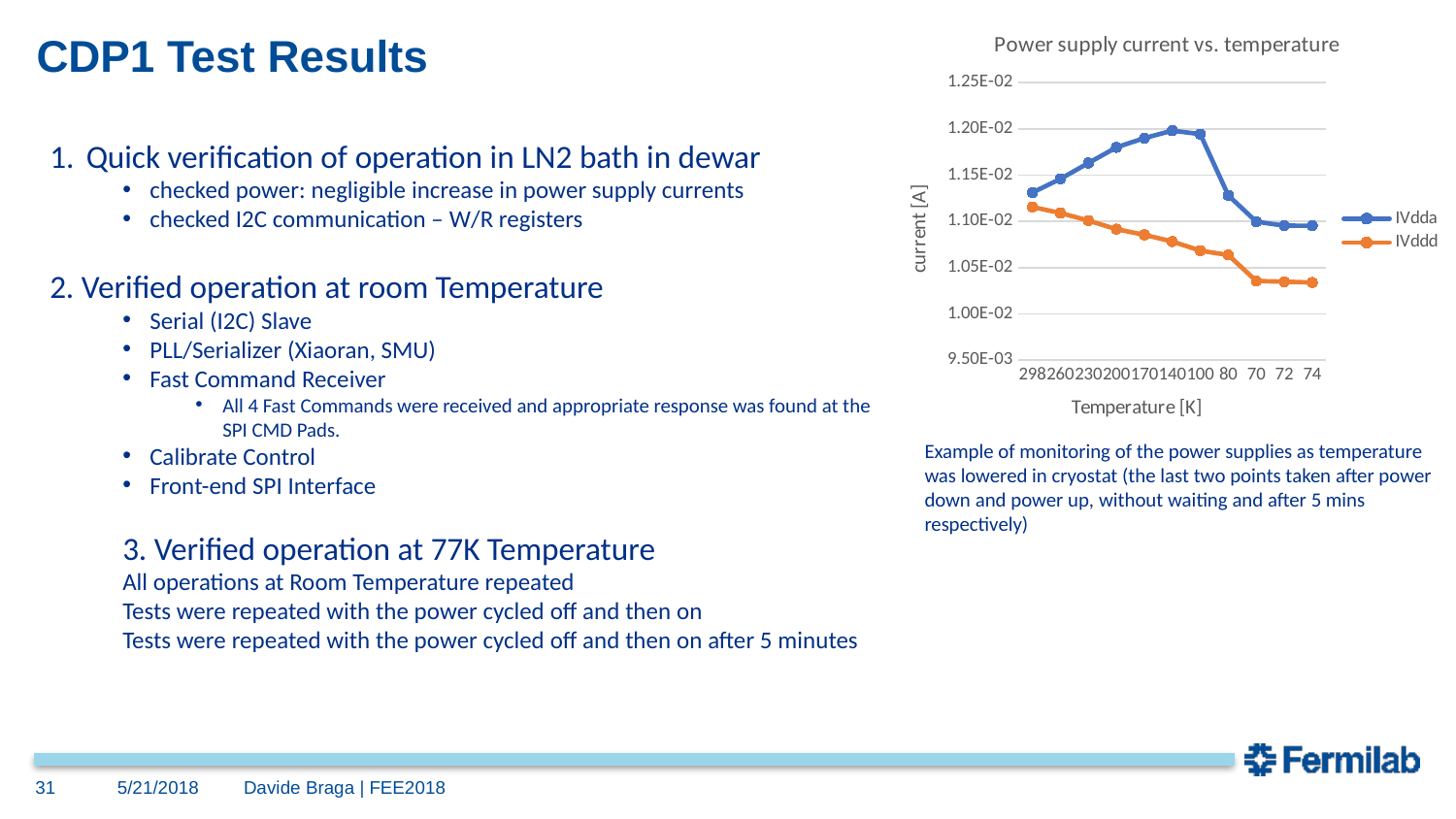
Is the IVddd value at 298 K greater or less than 1.10E-02? greater Does the IVddd series generally rise or fall moving from left to right along the x axis? fall At 298 K, which series has the higher current, IVdda or IVddd? IVdda Is the IVddd value at 70 K greater or less than 1.05E-02? less What kind of chart is shown on the slide? line chart Is the IVdda value at 298 K greater or less than 1.10E-02? greater How many series does the chart legend list? 2 How many temperature points are plotted along the x axis of the chart? 11 What are the names of the two series in the chart legend? IVdda and IVddd What is the title of the chart? Power supply current vs. temperature